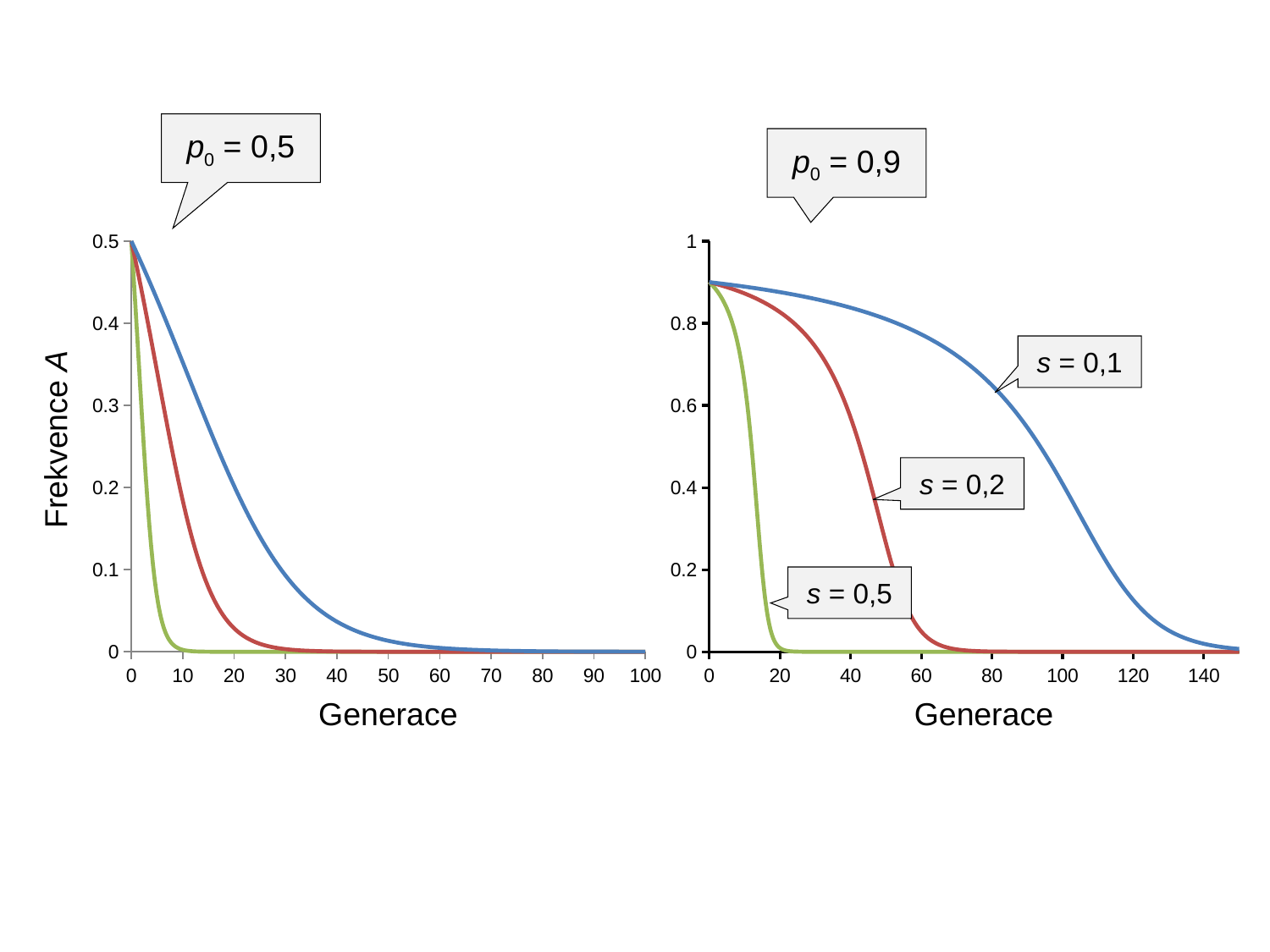
In the right chart (p0 = 0,9), what are the three s values labelled on the curves? s = 0,1; s = 0,2; s = 0,5 In the right chart (p0 = 0,9), do the curves rise or fall as the generation increases? fall What kind of chart is the left chart (p0 = 0,5)? line chart In the left chart (p0 = 0,5), is the value of the blue curve at generation 10 greater or less than 0.3? greater How many curves are plotted in the right chart (p0 = 0,9)? 3 In the left chart (p0 = 0,5), what is the frequency of A at generation 0? 0.5 In the right chart (p0 = 0,9), is the value of the s = 0,2 curve at generation 60 greater or less than 0.2? less In the right chart (p0 = 0,9), at generation 60, which curve has the higher frequency: s = 0,1 or s = 0,2? s = 0,1 In the right chart (p0 = 0,9), which curve reaches a frequency of 0 first? s = 0,5 What is the label of the x axis on both charts? Generace In the right chart (p0 = 0,9), is the value of the s = 0,1 curve at generation 80 greater or less than 0.6? greater In the right chart (p0 = 0,9), which curve stays highest for the longest number of generations? s = 0,1